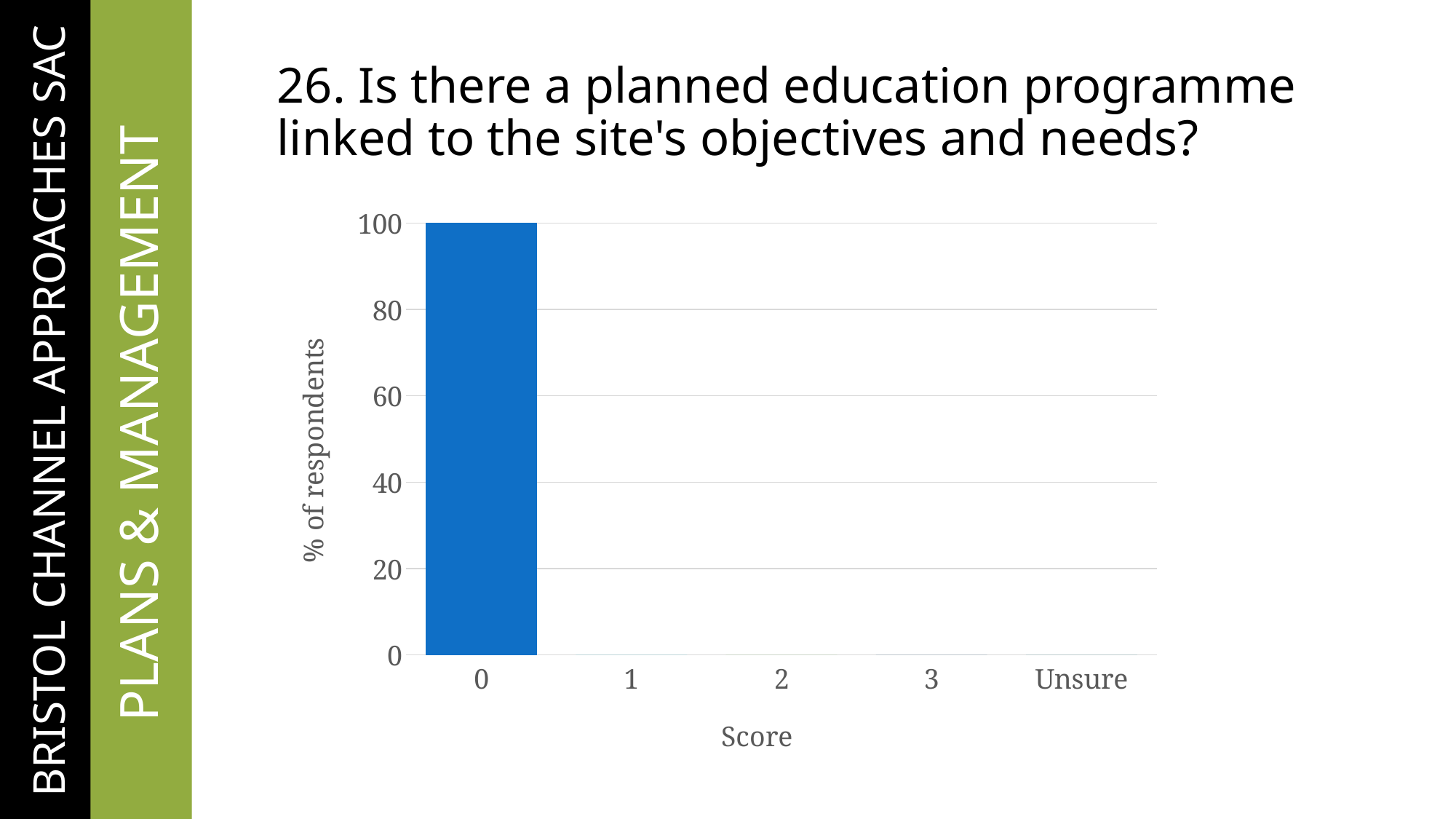
Is the value for score 0 greater or less than 80? greater What kind of chart is shown on the slide? bar chart What is the label on the y axis? % of respondents What is the label on the x axis? Score What is the % of respondents for score 0? 100 What is the difference in % of respondents between score 0 and score 3? 100 How many score categories have a visible bar? 1 What is the % of respondents for the Unsure category? 0 Which score category has the highest % of respondents? 0 How many score categories are shown on the x axis? 5 Which has a larger % of respondents, score 0 or score 1? 0